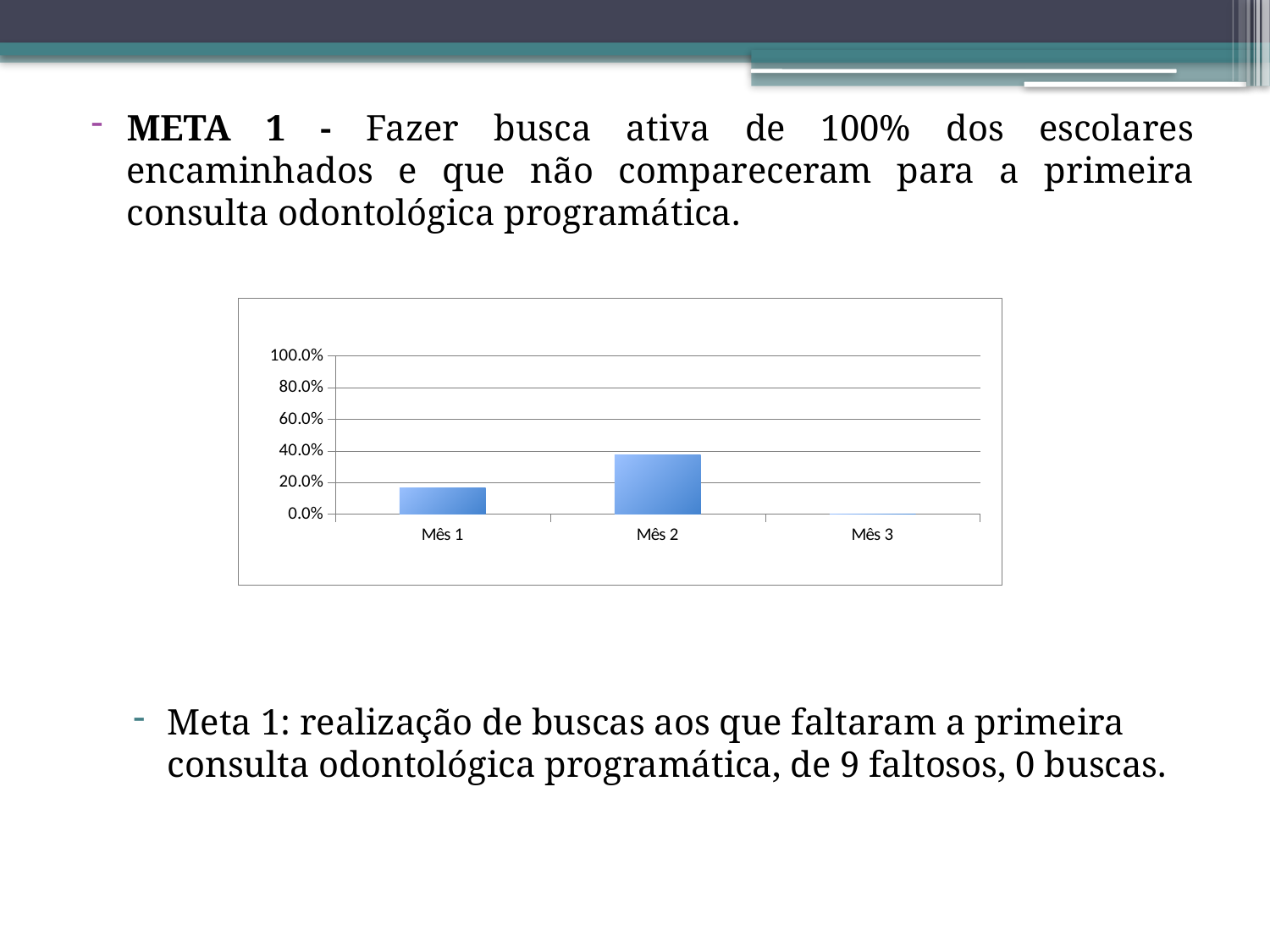
Does the value rise or fall from Mês 1 to Mês 2? rise What is the value shown for Mês 3 in the chart? 0.0% Is the value for Mês 1 greater or less than 40.0%? less Which is larger, the value for Mês 1 or the value for Mês 2? Mês 2 Is the value for Mês 2 greater or less than 20.0%? greater What kind of chart is shown on the slide? bar chart What are the category labels on the x axis of the chart? Mês 1, Mês 2, Mês 3 How many categories are shown on the x axis of the chart? 3 Which month has the lowest value in the chart? Mês 3 Which month has the highest value in the chart? Mês 2 What is the highest value labelled on the y axis of the chart? 100.0% Is the value for Mês 2 greater or less than 60.0%? less